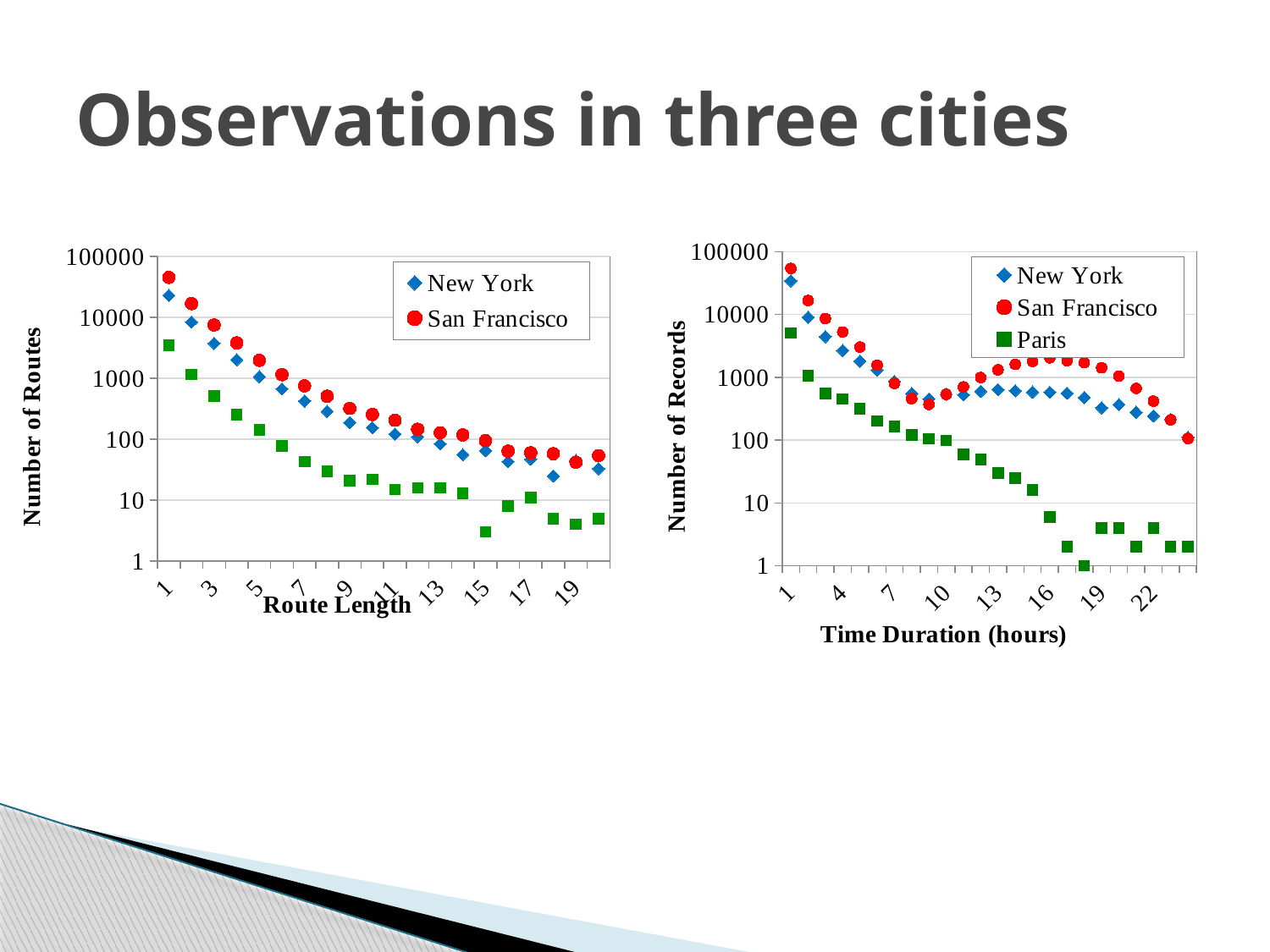
In the right chart, is the Paris value at time duration 1 hour greater or less than 10000? less What kind of chart is the left chart (Number of Routes vs Route Length)? scatter chart How many series does the legend of the right chart (Number of Records vs Time Duration) list? 3 In the left chart, which series has the larger value at route length 1, New York or San Francisco? San Francisco In the right chart, do the Paris values generally rise or fall as time duration increases? fall In the left chart, do the San Francisco values generally rise or fall as route length increases? fall How many series does the legend of the left chart (Number of Routes vs Route Length) list? 2 In the right chart, is the Paris value at time duration 1 hour greater or less than 1000? greater In the left chart, is the San Francisco value at route length 1 greater or less than 10000? greater In the right chart, which series has the larger value at time duration 16 hours, New York or San Francisco? San Francisco In the right chart, which series is shown with green squares? Paris What is the x-axis title of the right chart? Time Duration (hours)